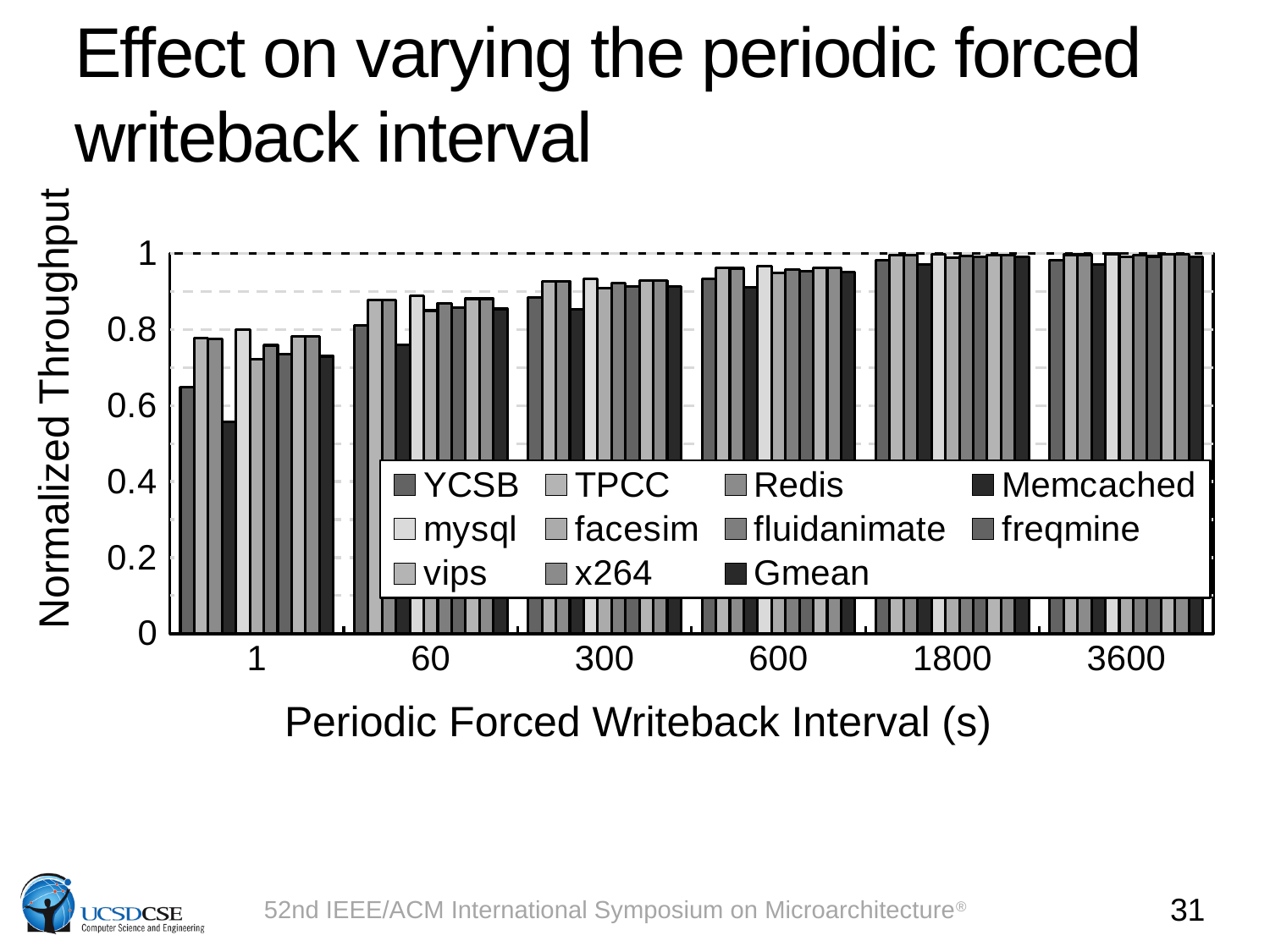
How many series does the legend list? 11 Which is larger: the Gmean value at a writeback interval of 1 or at 600? 600 What is the label of the y axis? Normalized Throughput Is the Memcached value at a writeback interval of 1 greater or less than 0.6? less Is the Gmean value at a writeback interval of 300 greater or less than 0.8? greater Which series has the lowest normalized throughput at a writeback interval of 1? Memcached Do the normalized throughput values generally rise or fall as the writeback interval increases along the x axis? rise Is the Memcached value at a writeback interval of 60 greater or less than 0.8? less What is the label of the x axis? Periodic Forced Writeback Interval (s) How many periodic forced writeback interval categories are shown on the x axis? 6 What kind of chart is shown on the slide? bar chart